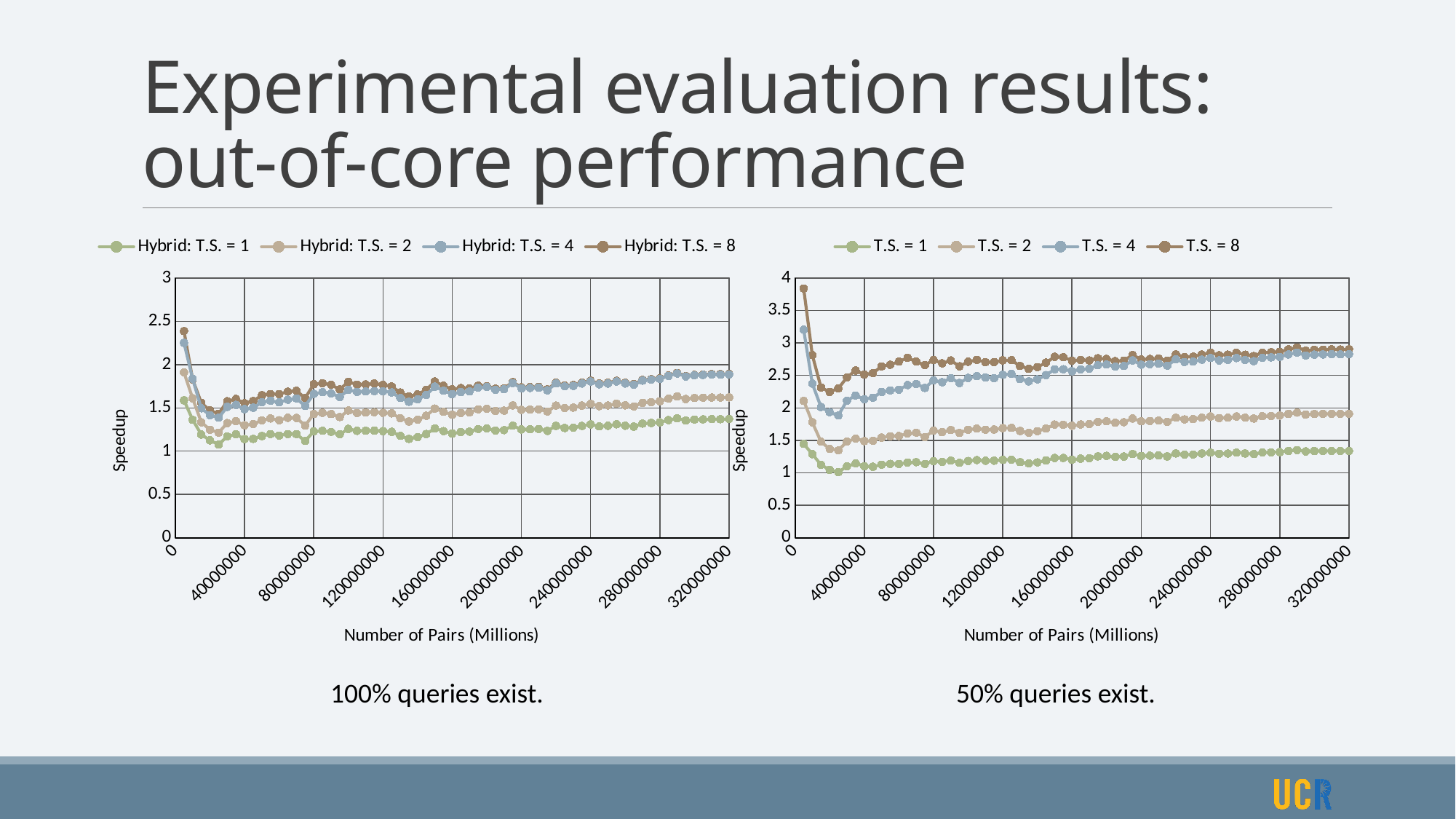
How many series does the legend of the right chart (50% queries exist.) list? 4 What is the label of the x axis on the right chart (50% queries exist.)? Number of Pairs (Millions) In the left chart (100% queries exist.), is the value for Hybrid: T.S. = 4 at 320000000 pairs greater or less than 2? less What kind of chart is the left chart titled "100% queries exist."? line chart In the right chart (50% queries exist.), is the value for T.S. = 8 at 320000000 pairs greater or less than 2.5? greater In the left chart (100% queries exist.), is the value for Hybrid: T.S. = 1 at 320000000 pairs greater or less than 1.5? less In the right chart (50% queries exist.), does the T.S. = 8 series rise or fall between 0 and 40000000 pairs? fall In the right chart (50% queries exist.), which series has the highest speedup at the first plotted point? T.S. = 8 In the left chart (100% queries exist.), at 320000000 pairs, which is larger: Hybrid: T.S. = 4 or Hybrid: T.S. = 1? Hybrid: T.S. = 4 In the left chart (100% queries exist.), which series has the lowest speedup across the x axis? Hybrid: T.S. = 1 How many series does the legend of the left chart (100% queries exist.) list? 4